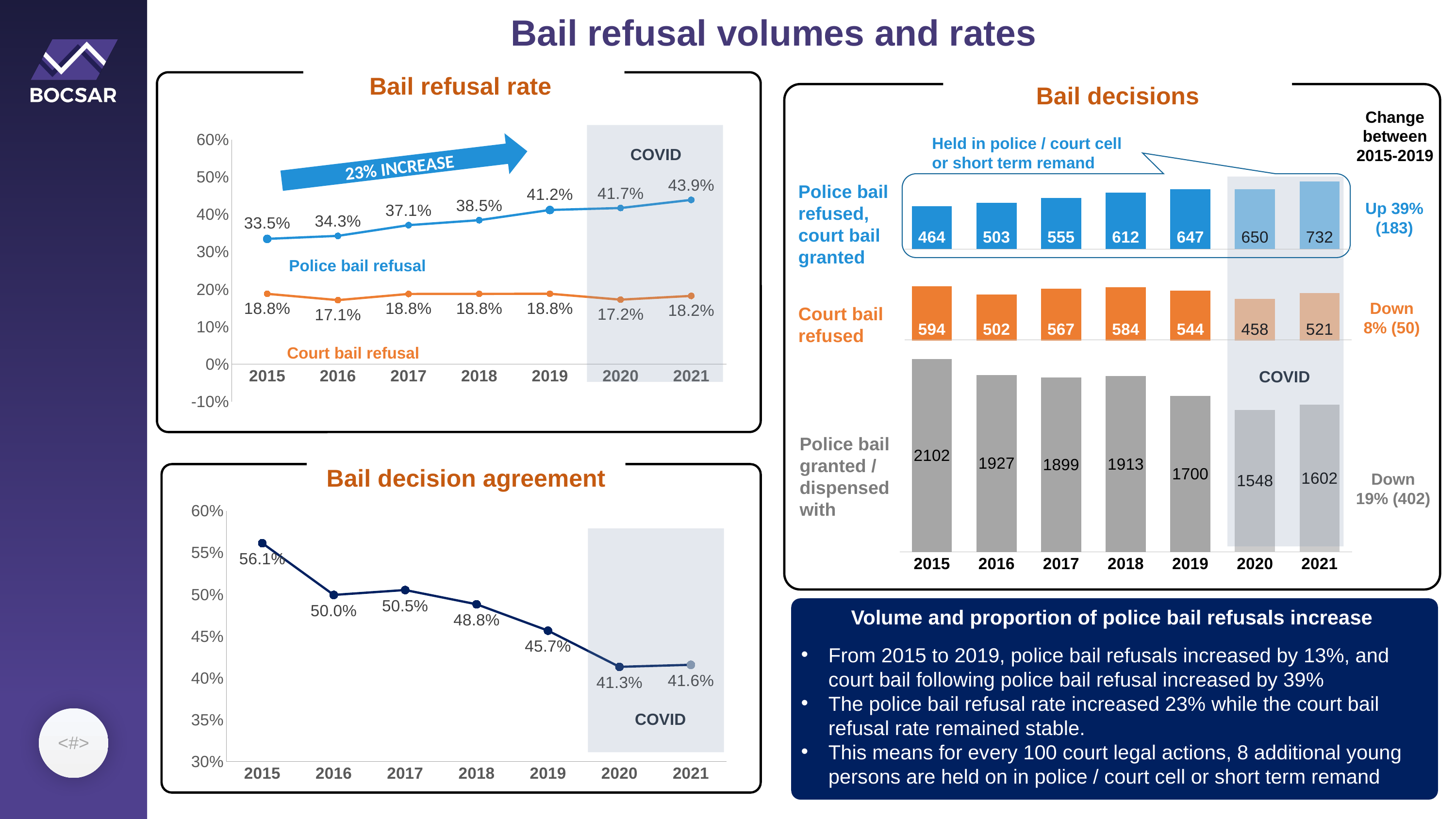
In the 'Bail decisions' chart, what is the number of court bail refused in 2018? 584 In the 'Bail decision agreement' chart, how many years are plotted on the x axis? 7 In the 'Bail refusal rate' chart, what is the difference between the police bail refusal rate and the court bail refusal rate in 2021? 25.7% What kind of chart is the 'Bail decisions' chart? bar chart In the 'Bail decisions' chart, which year has the highest value for police bail granted / dispensed with? 2015 In the 'Bail refusal rate' chart, what is the police bail refusal rate in 2019? 41.2% In the 'Bail refusal rate' chart, does the police bail refusal rate rise or fall from 2015 to 2021? rise In the 'Bail decisions' chart, is the value for police bail refused, court bail granted larger in 2015 or in 2021? 2021 In the 'Bail decision agreement' chart, what is the value for 2018? 48.8% In the 'Bail refusal rate' chart, which year has the highest police bail refusal rate? 2021 In the 'Bail refusal rate' chart, what is the court bail refusal rate in 2016? 17.1% In the 'Bail decision agreement' chart, which year has the lowest value? 2020